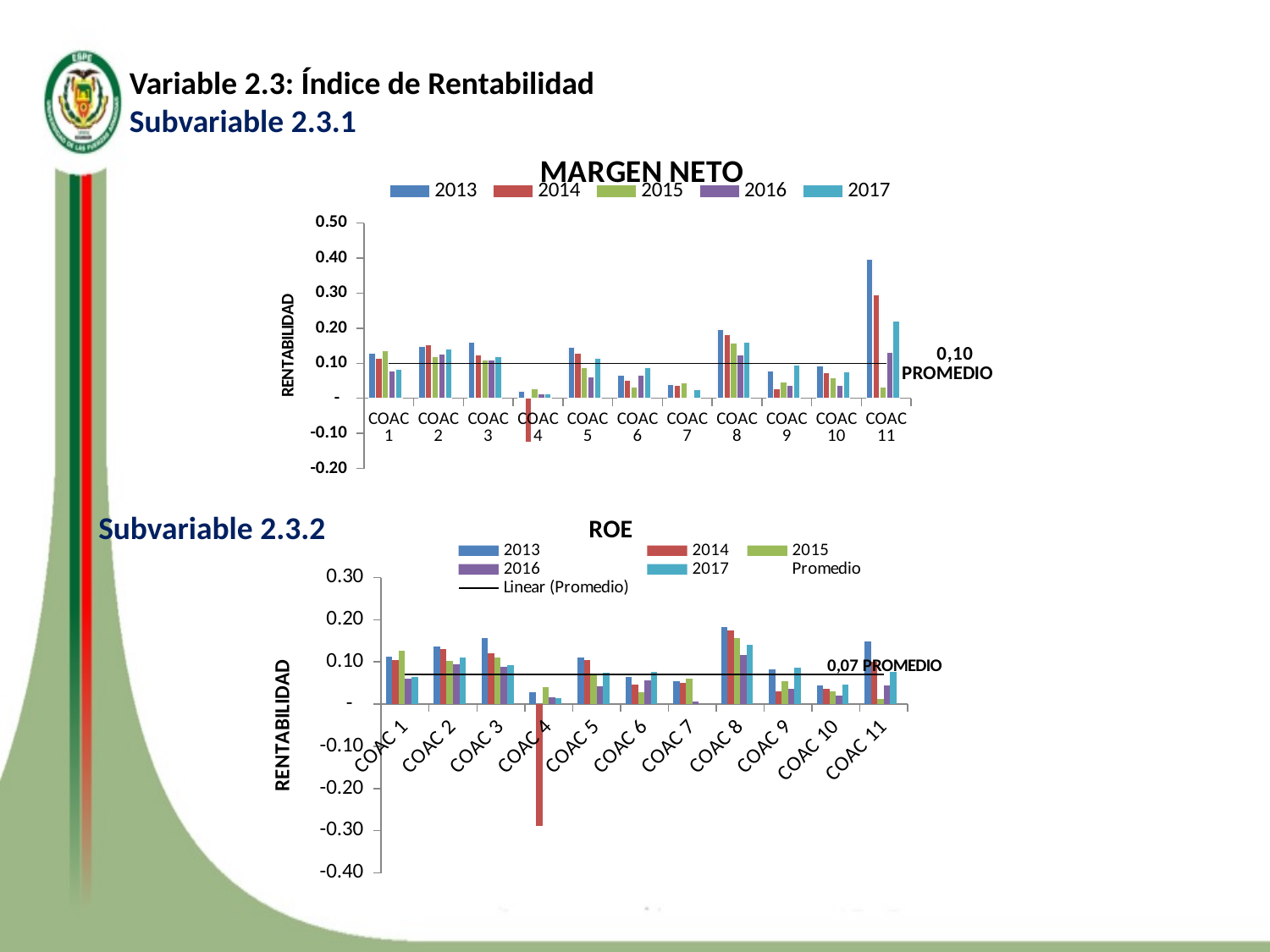
What is the y-axis title of the ROE chart? RENTABILIDAD What average (PROMEDIO) value is labelled on the MARGEN NETO chart? 0,10 In the ROE chart, is the 2014 value for COAC 4 greater or less than -0.20? less What average (PROMEDIO) value is labelled on the ROE chart? 0,07 In the MARGEN NETO chart, which is larger, the 2013 value for COAC 11 or the 2013 value for COAC 8? COAC 11 In the ROE chart, which COAC has the lowest bar? COAC 4 How many COAC categories are shown on the x axis of the MARGEN NETO chart? 11 In the MARGEN NETO chart, which COAC has the highest bar? COAC 11 How many series does the legend of the MARGEN NETO chart list? 5 What kind of chart is the MARGEN NETO chart? bar chart In the MARGEN NETO chart, which COAC has the lowest (negative) bar? COAC 4 In the MARGEN NETO chart, is the 2013 value for COAC 11 greater or less than 0.30? greater